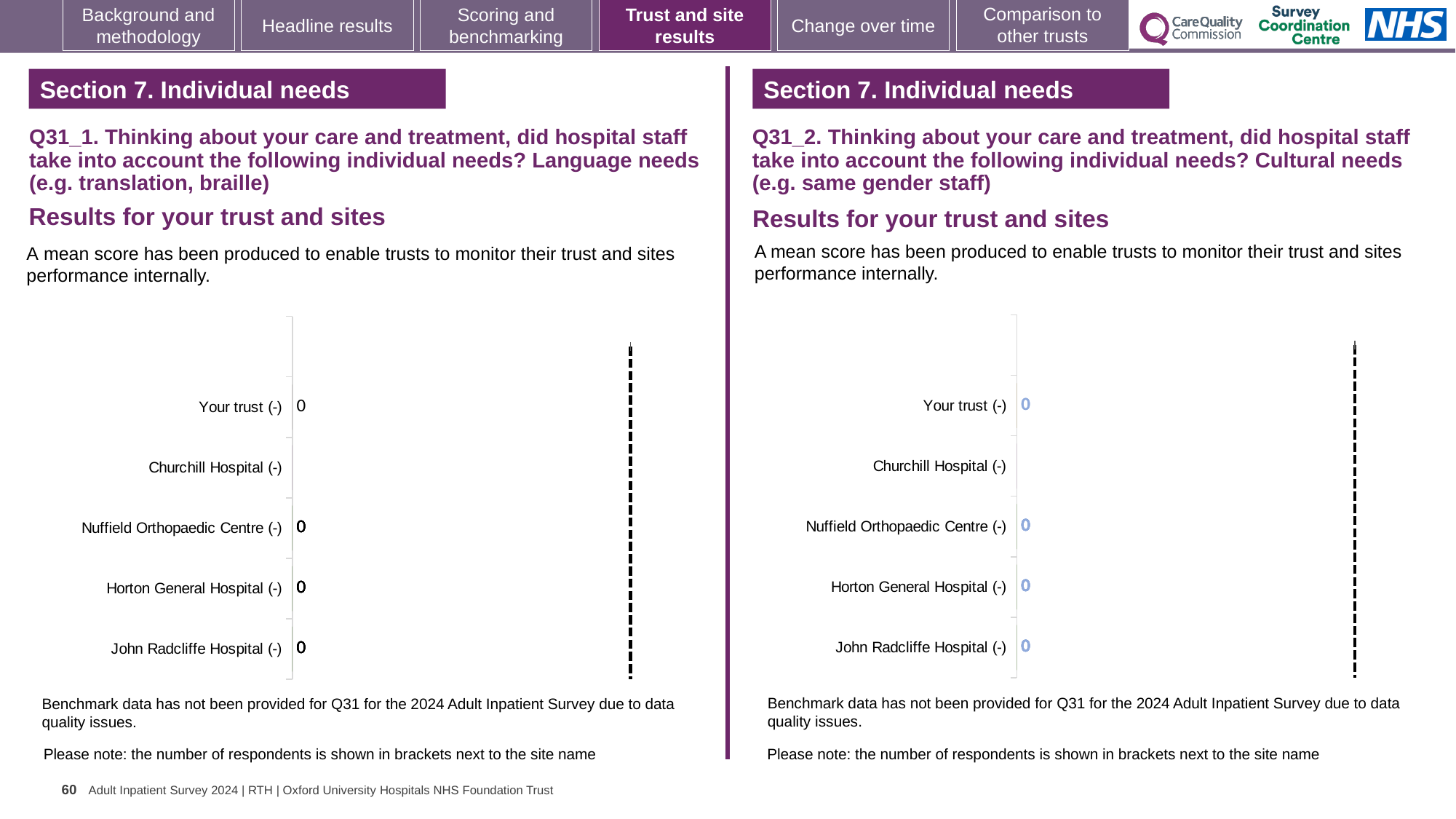
What kind of chart is used on the left side of the slide for Q31_1? Bar chart According to the note below the charts, why has benchmark data not been provided for Q31? Due to data quality issues On the right chart (Q31_2, Cultural needs), what is the value shown for John Radcliffe Hospital? 0 On the right chart (Q31_2, Cultural needs), what is the value shown for Your trust? 0 On the left chart (Q31_1, Language needs), what is the value shown for John Radcliffe Hospital? 0 On the right chart (Q31_2, Cultural needs), what is the value shown for Nuffield Orthopaedic Centre? 0 On the left chart (Q31_1, Language needs), what is the difference between the values for Your trust and Horton General Hospital? 0 Which category on the right chart (Q31_2, Cultural needs) has no data label shown? Churchill Hospital (-) On the left chart (Q31_1, Language needs), what is the value shown for Horton General Hospital? 0 How many categories are listed on the right chart (Q31_2, Cultural needs)? 5 On the left chart (Q31_1, Language needs), what is the value shown for Your trust? 0 How many categories are listed on the left chart (Q31_1, Language needs)? 5